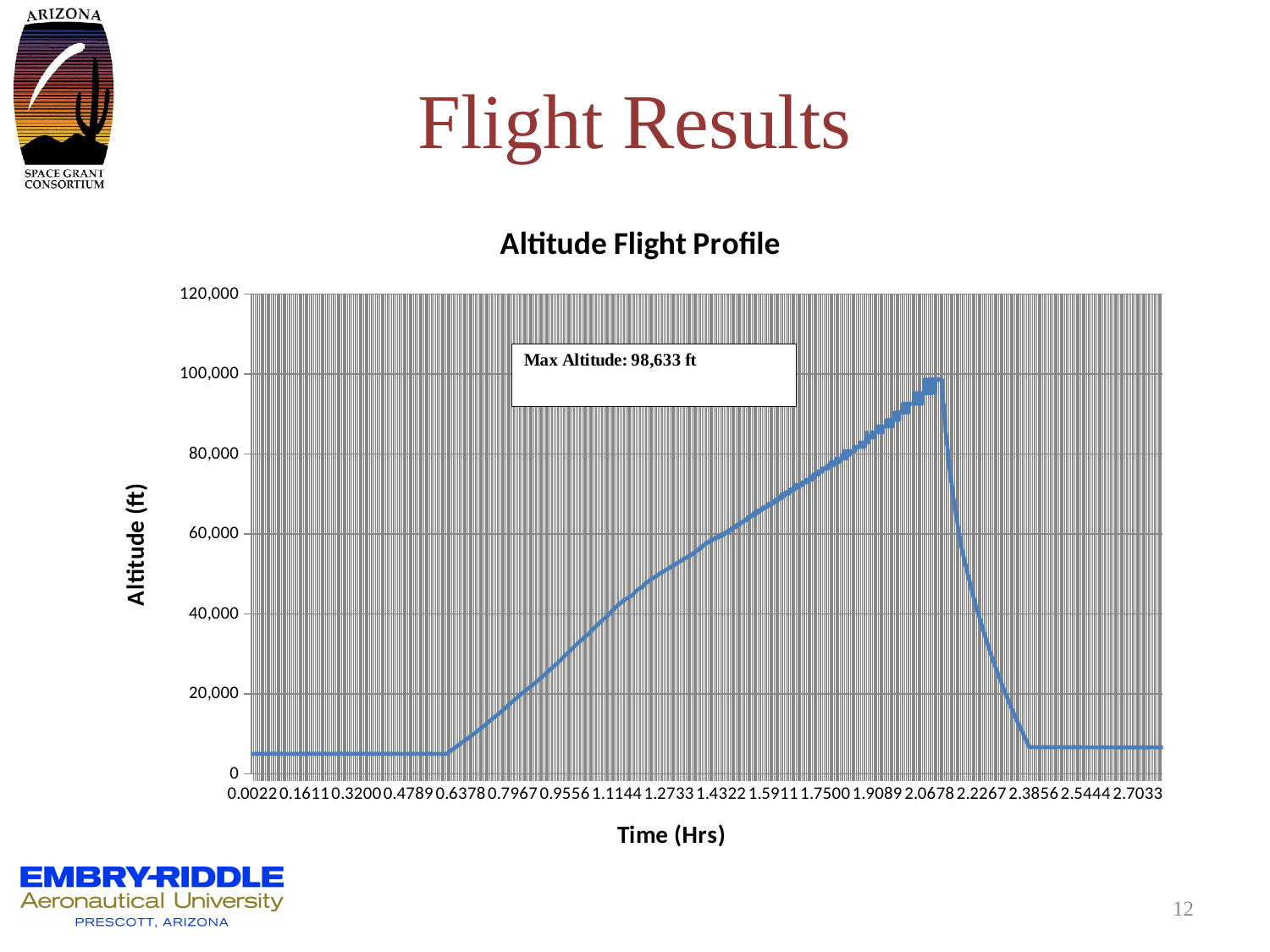
Is the altitude at time 2.5444 hrs greater or less than 20,000 ft? less What kind of chart is shown on the slide? line chart Is the altitude at time 1.7500 hrs greater or less than 60,000 ft? greater Does the altitude rise or fall between 2.0678 hrs and 2.3856 hrs? fall Is the altitude at time 0.9556 hrs greater or less than 40,000 ft? less Which is higher, the altitude at 1.2733 hrs or the altitude at 2.5444 hrs? 1.2733 hrs What is the title of the chart? Altitude Flight Profile What is the maximum altitude reached according to the annotation on the chart? 98,633 ft Does the altitude rise or fall between 0.6378 hrs and 2.0678 hrs? rise What is the label of the vertical axis? Altitude (ft)